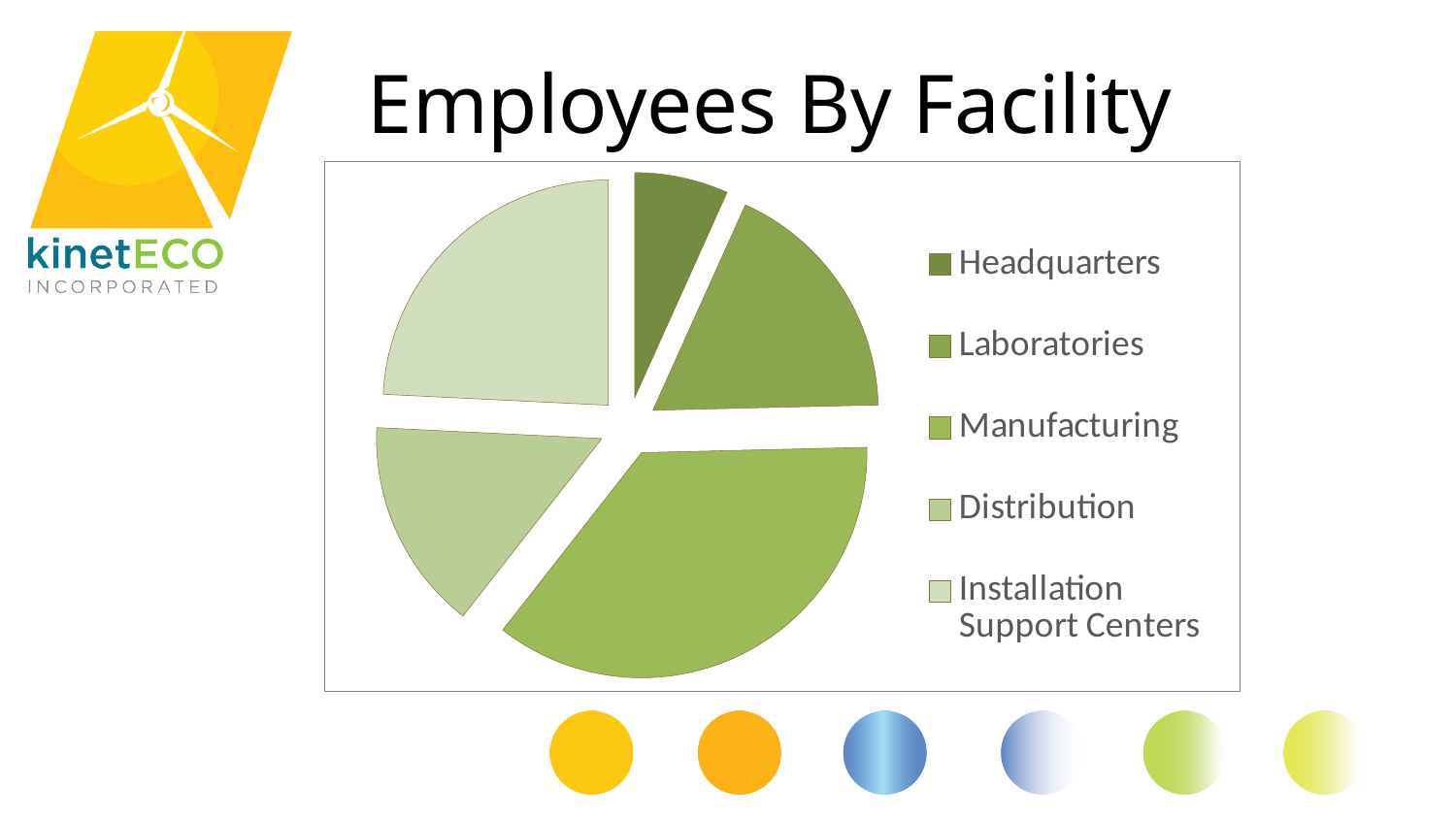
Which has a larger share of employees, Installation Support Centers or Distribution? Installation Support Centers Which has a larger share of employees, Manufacturing or Headquarters? Manufacturing Which has a larger share of employees, Manufacturing or Installation Support Centers? Manufacturing Which facility has the largest share of employees? Manufacturing How many slices does the pie chart have? 5 How many entries does the legend list? 5 Which legend entry is listed last in the legend? Installation Support Centers What is the title of the chart? Employees By Facility Which facility has the smallest share of employees? Headquarters What kind of chart is shown on the slide? Pie chart